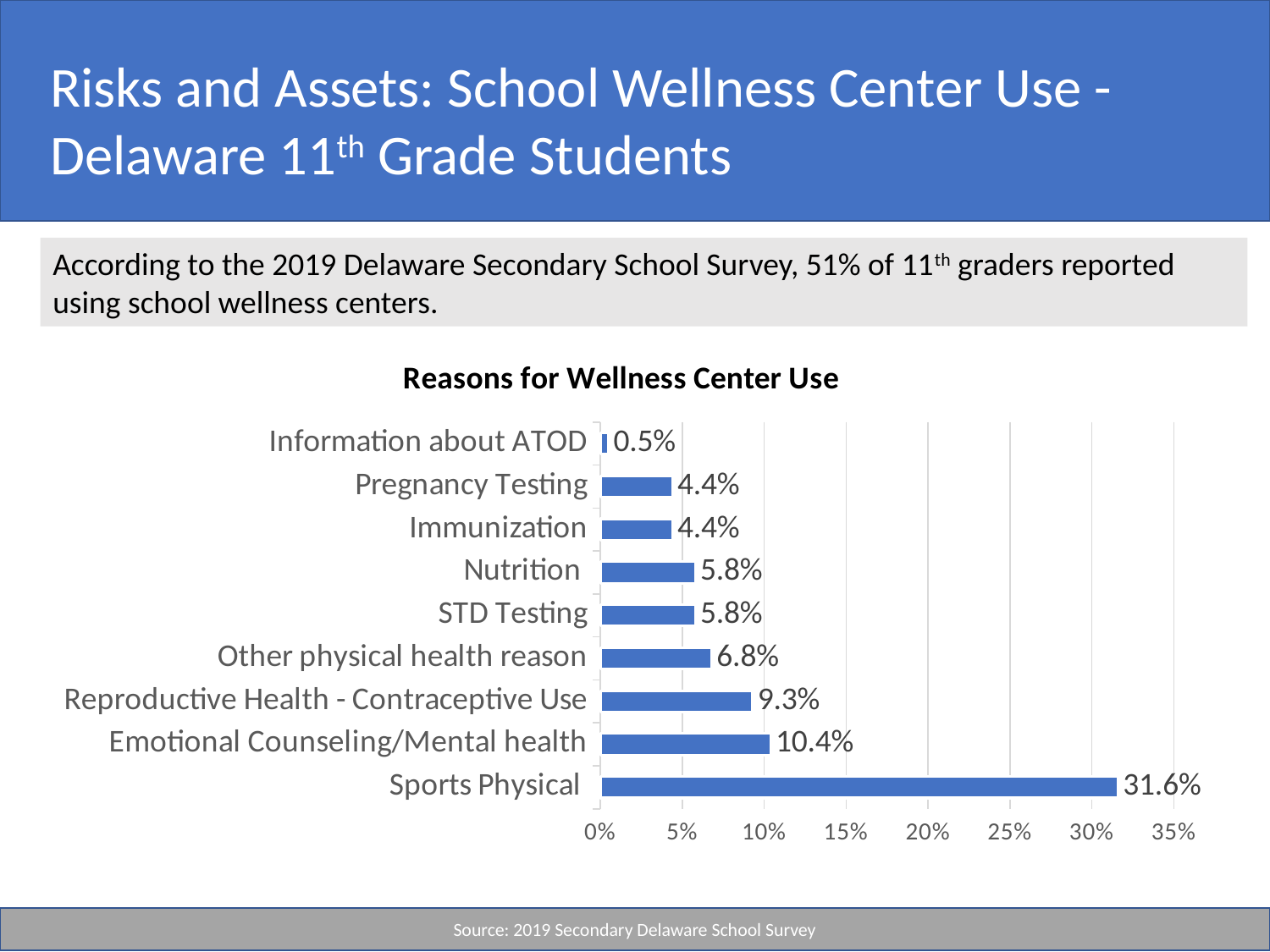
What is the difference between the values for Sports Physical and Emotional Counseling/Mental health? 21.2% Which reason for wellness center use has the highest value? Sports Physical What is the value for Sports Physical? 31.6% What is the value for Reproductive Health - Contraceptive Use? 9.3% What is the value for Information about ATOD? 0.5% What kind of chart is shown on the slide? Bar chart Which is larger, the value for Other physical health reason or the value for Nutrition? Other physical health reason Which reason for wellness center use has the lowest value? Information about ATOD Is the value for Sports Physical greater or less than 30%? greater What is the value for Emotional Counseling/Mental health? 10.4% How many categories are shown in the chart? 9 What is the title of the chart? Reasons for Wellness Center Use